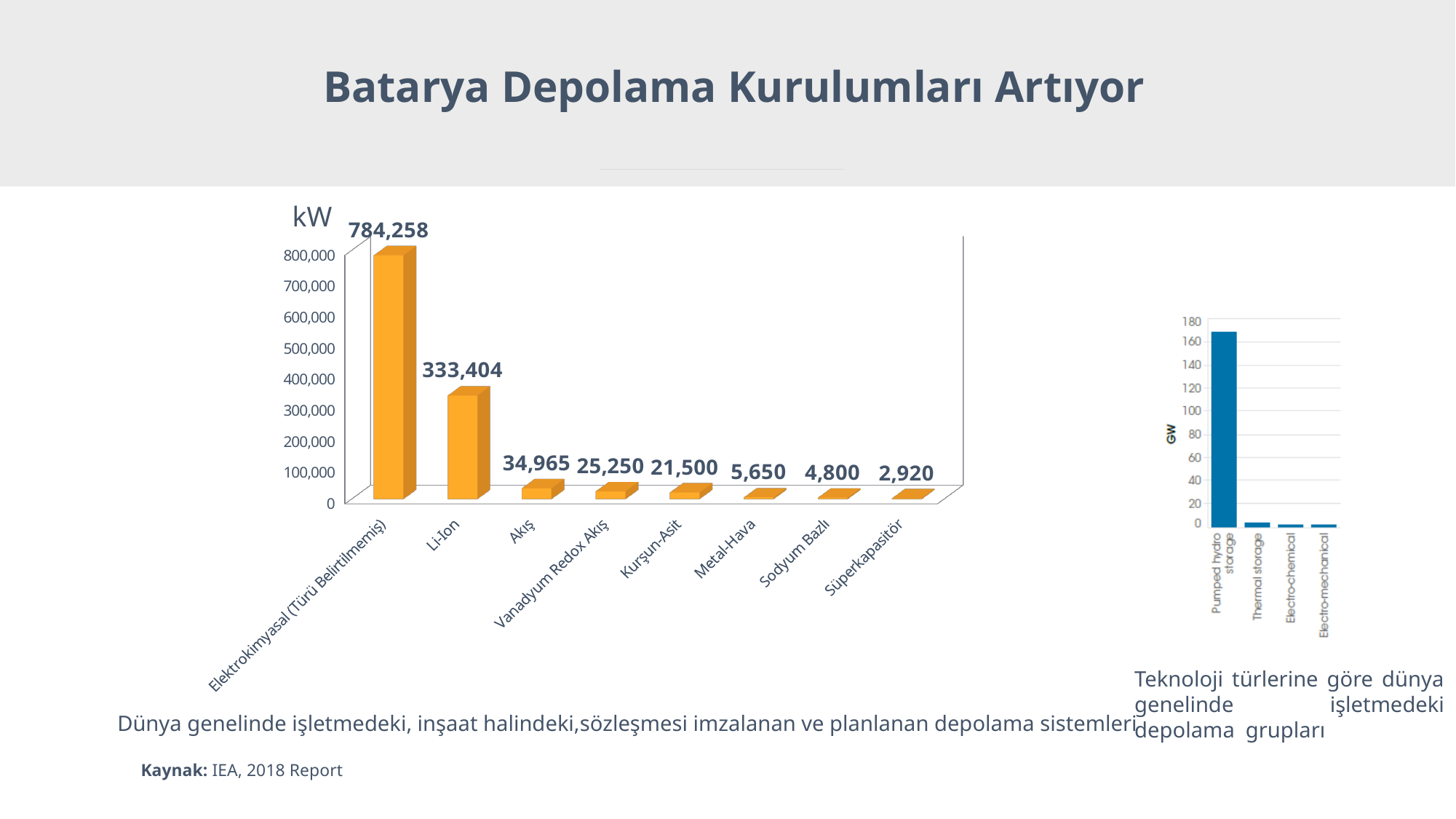
On the left chart, what is the value for Kurşun-Asit? 21,500 What unit is shown on the y axis of the right chart? GW On the right chart, is the value for Thermal storage greater or less than 20? less On the left chart, what is the value for Li-ion? 333,404 What kind of chart is the left chart? Bar chart On the right chart, is the value for Pumped hydro storage greater or less than 140? greater On the left chart, what is the difference between the values for Akış and Vanadyum Redox Akış? 9,715 On the left chart, which category has the lowest value? Süperkapasitör On the left chart, which is larger: Metal-Hava or Sodyum Bazlı? Metal-Hava On the left chart, which category has the highest value? Elektrokimyasal (Türü Belirtilmemiş) How many categories are shown on the left chart? 8 On the left chart, what is the value for Süperkapasitör? 2,920